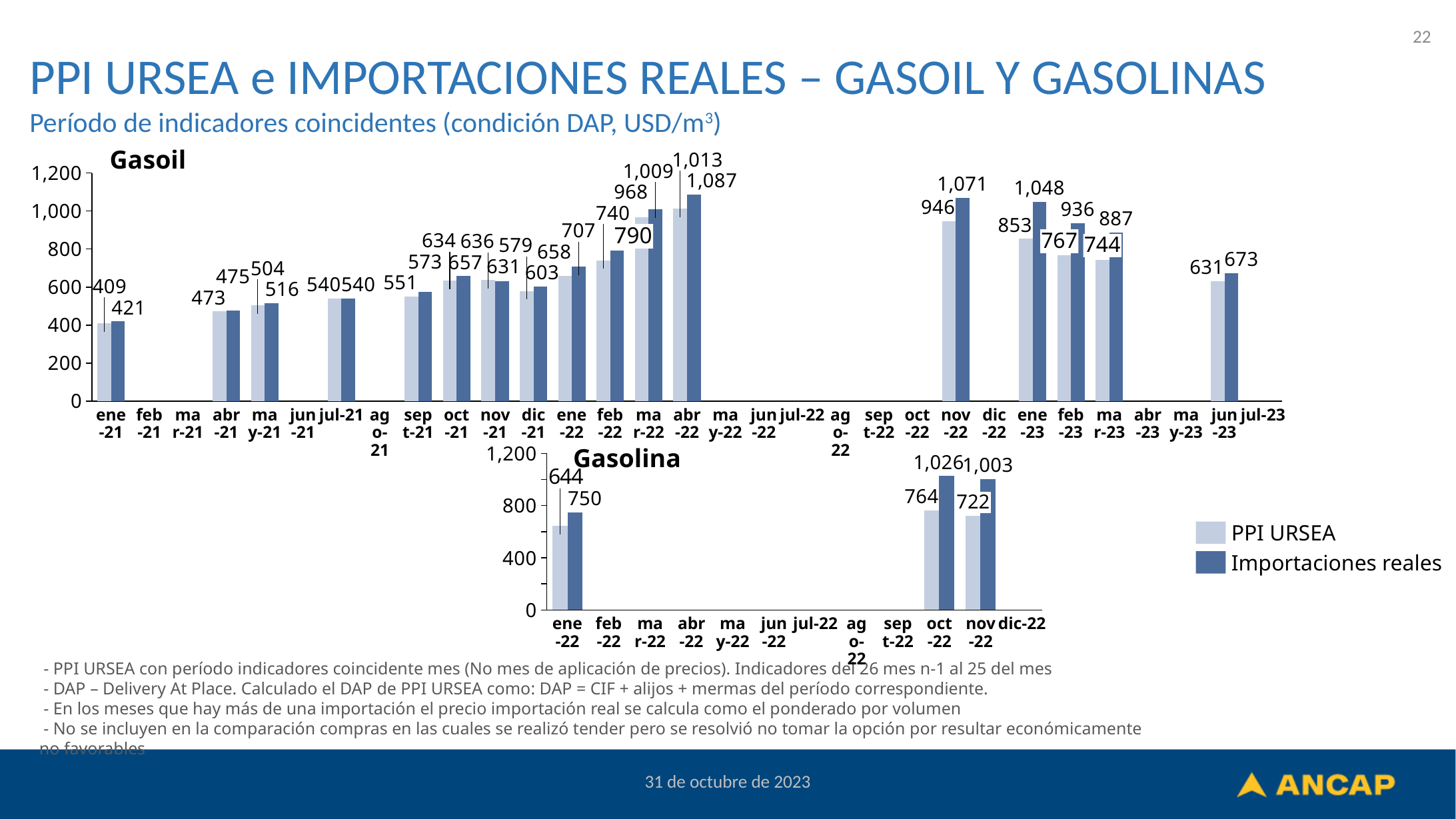
In the Gasoil chart, which month has the highest Importaciones reales value? abr-22 In the Gasoil chart, which is larger for feb-23: PPI URSEA or Importaciones reales? Importaciones reales What type of chart is the Gasoil chart? Bar chart How many months in the Gasolina chart have bars plotted? 3 In the Gasolina chart, which month has the highest Importaciones reales value? oct-22 In the Gasolina chart, what is the Importaciones reales value for ene-22? 750 In the Gasoil chart, what is the Importaciones reales value for abr-22? 1,087 In the Gasoil chart, what is the difference between Importaciones reales and PPI URSEA for nov-22? 125 In the Gasoil chart, what is the PPI URSEA value for nov-22? 946 How many series does the legend list? 2 In the Gasoil chart, which month has the lowest PPI URSEA value? ene-21 In the Gasolina chart, what is the difference between Importaciones reales and PPI URSEA for oct-22? 262